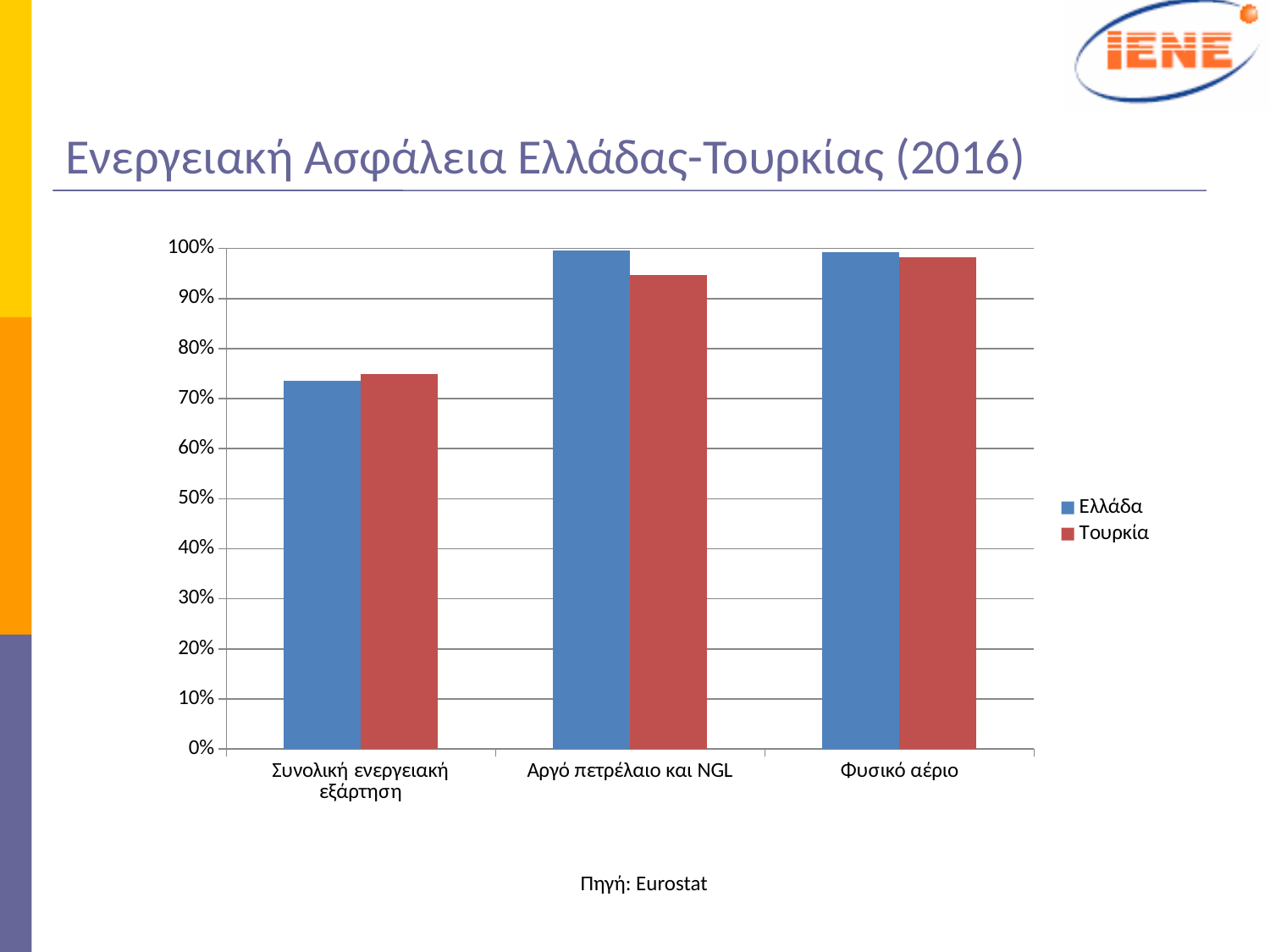
What is the title of the chart on the slide? Ενεργειακή Ασφάλεια Ελλάδας-Τουρκίας (2016) How many series does the legend list? 2 Which category has the lowest value for Ελλάδα? Συνολική ενεργειακή εξάρτηση What kind of chart is shown on the slide? bar chart Is the value for Ελλάδα in Συνολική ενεργειακή εξάρτηση greater or less than 70%? greater For Αργό πετρέλαιο και NGL, which is larger, the value for Ελλάδα or for Τουρκία? Ελλάδα Is the value for Τουρκία in Συνολική ενεργειακή εξάρτηση greater or less than 80%? less How many categories are shown on the x axis of the chart? 3 Which colour represents Τουρκία in the chart? red Is the value for Ελλάδα in Φυσικό αέριο greater or less than 90%? greater Which category has the highest value for Τουρκία? Φυσικό αέριο